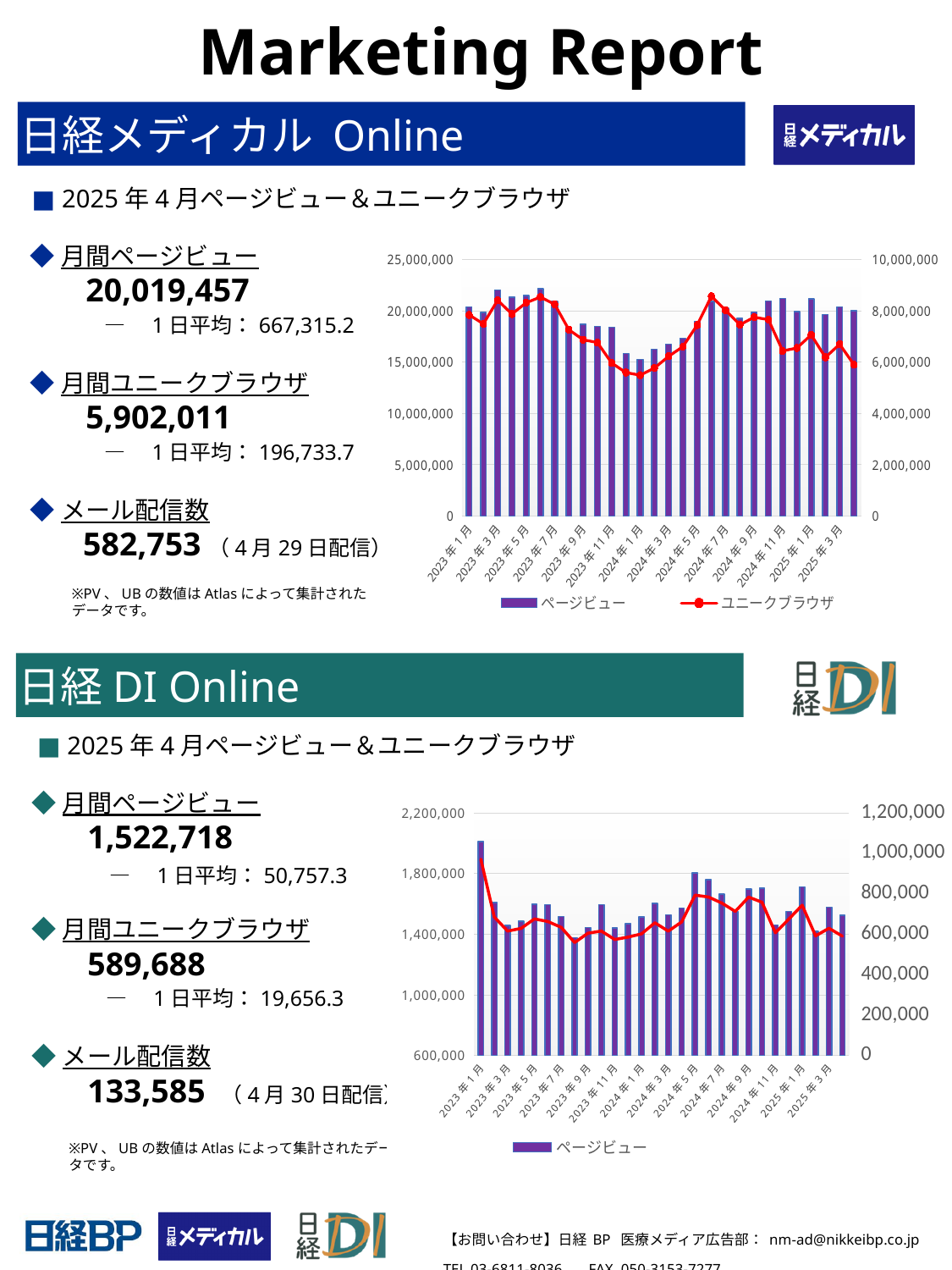
In the 日経メディカル Online chart, is the ページビュー value for 2023年5月 greater or less than 20,000,000? greater In the 日経メディカル Online chart, do the ページビュー values rise or fall from 2023年7月 to 2024年1月? fall In the 日経メディカル Online chart, which has the larger ページビュー value, 2023年5月 or 2024年1月? 2023年5月 What is the highest value shown on the right-hand axis of the 日経メディカル Online chart? 10,000,000 In the 日経 DI Online chart, do the ページビュー values rise or fall from 2023年1月 to 2023年3月? fall In the 日経 DI Online chart, which month has the highest ページビュー bar? 2023年1月 In the 日経 DI Online chart, is the ページビュー value for 2023年1月 greater or less than 1,800,000? greater In the 日経メディカル Online chart, is the ページビュー value for 2024年1月 greater or less than 20,000,000? less What kind of chart is shown in the 日経メディカル Online section? Combined bar and line chart How many series does the legend of the 日経メディカル Online chart list? 2 How many series does the legend of the 日経 DI Online chart list? 1